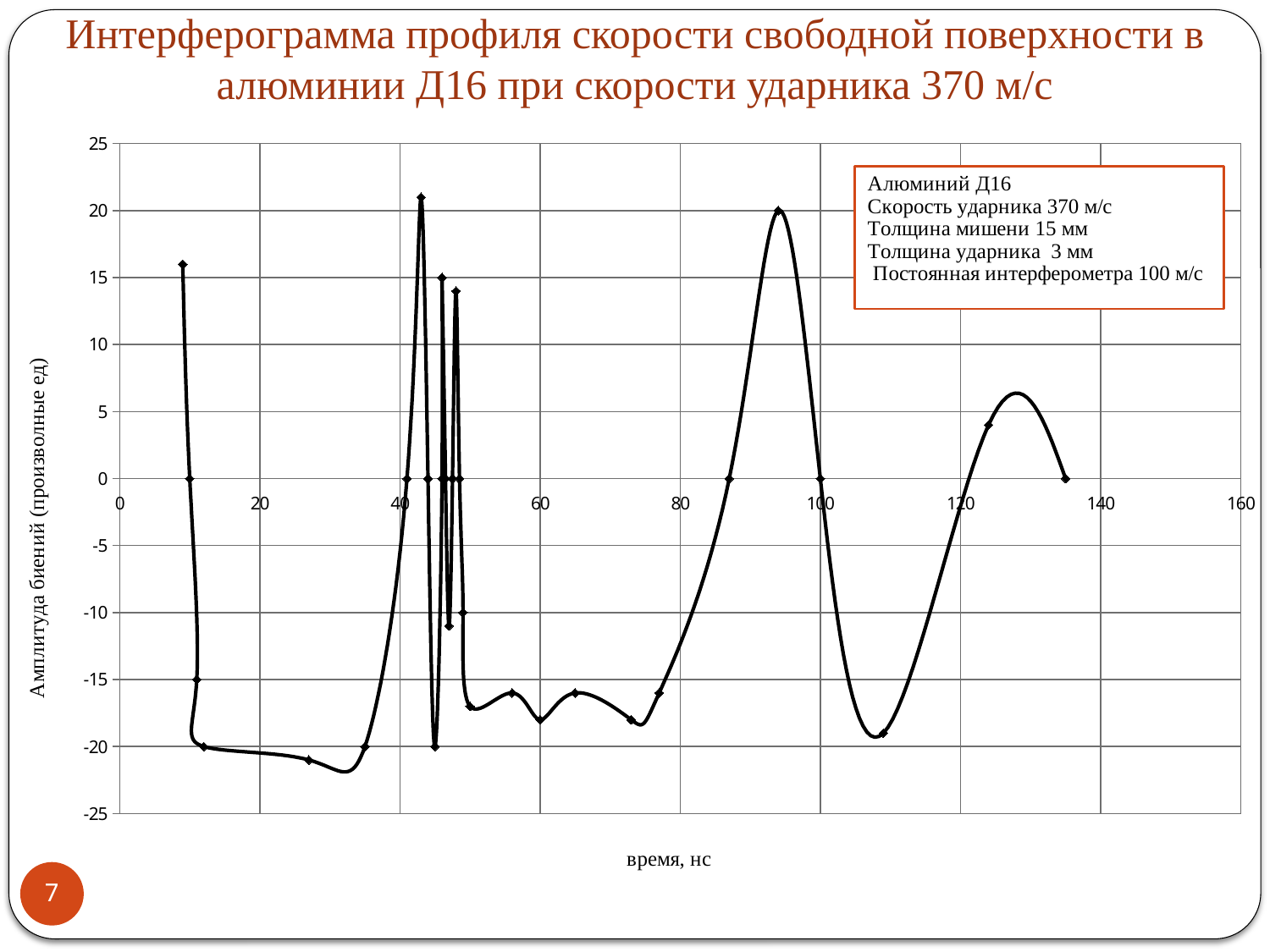
What is the title of the chart on the slide? Интерферограмма профиля скорости свободной поверхности в алюминии Д16 при скорости ударника 370 м/с What is the label of the x axis? время, нс Is the peak of the curve near 128 ns greater or less than 10? less Is the value of the curve at time 20 ns greater or less than -15? less Is the minimum of the curve near 108 ns greater or less than -15? less What is the value of the curve at time 100 ns? 0 Between 100 ns and 108 ns, does the curve rise or fall? fall Between 20 ns and 40 ns, does the curve rise or fall? rise What kind of chart is shown on the slide? line chart